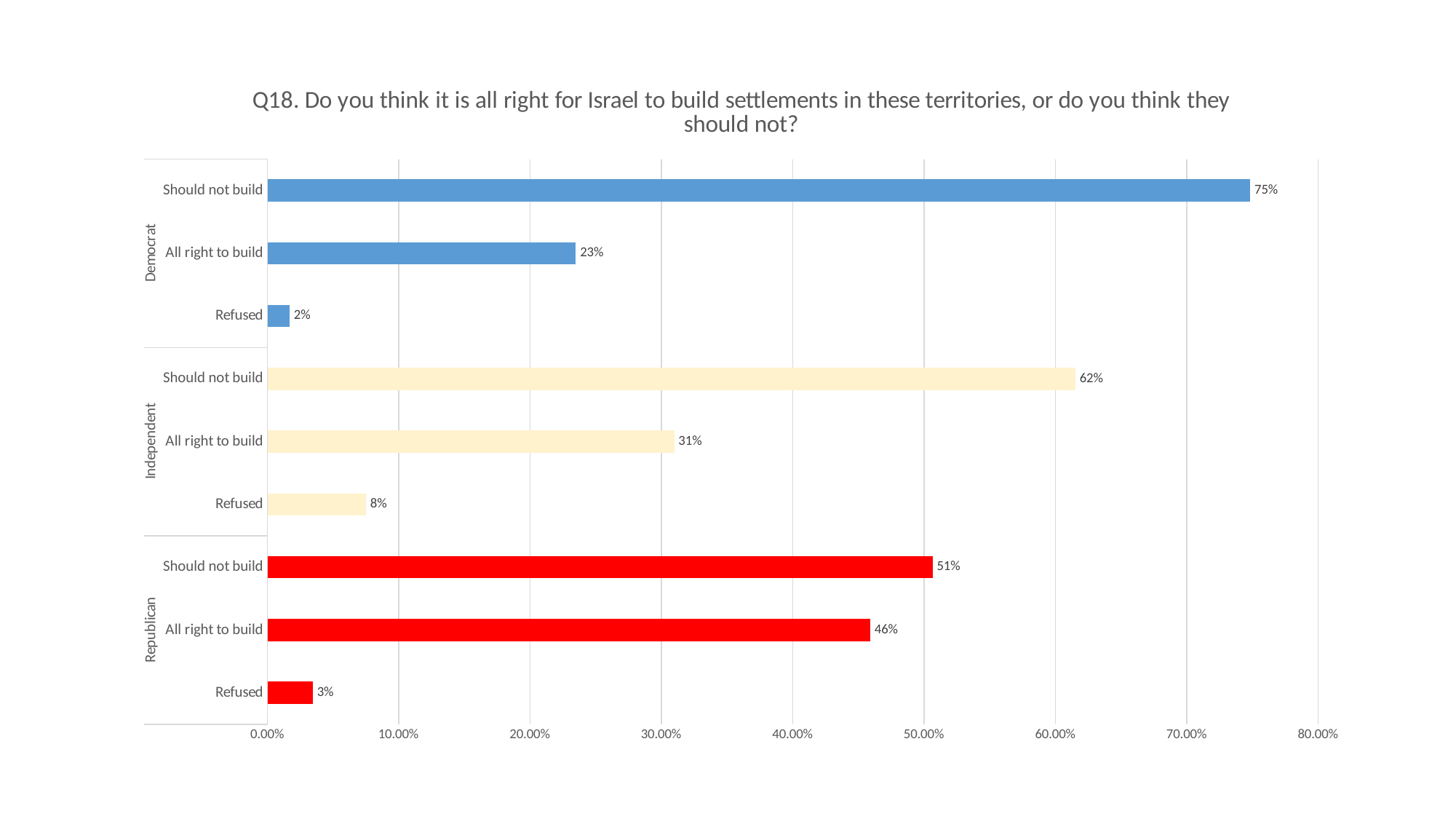
What percentage of Democrats said Israel should not build settlements? 75% What type of chart is shown on the slide? Bar chart What percentage of Republicans said it is all right to build? 46% What is the total of the three Republican response percentages? 100% How many bars are plotted on the chart? 9 Which party group has the lowest 'Refused' share? Democrat Which party group has the highest share saying 'Should not build'? Democrat What is the difference between the Democrat and Republican 'Should not build' percentages? 24% What percentage of Independents refused to answer? 8% Which is larger: the Independent 'All right to build' share or the Democrat 'All right to build' share? Independent What colour are the bars for the Republican group? Red Is the Republican 'Should not build' value greater or less than 50.00%? greater